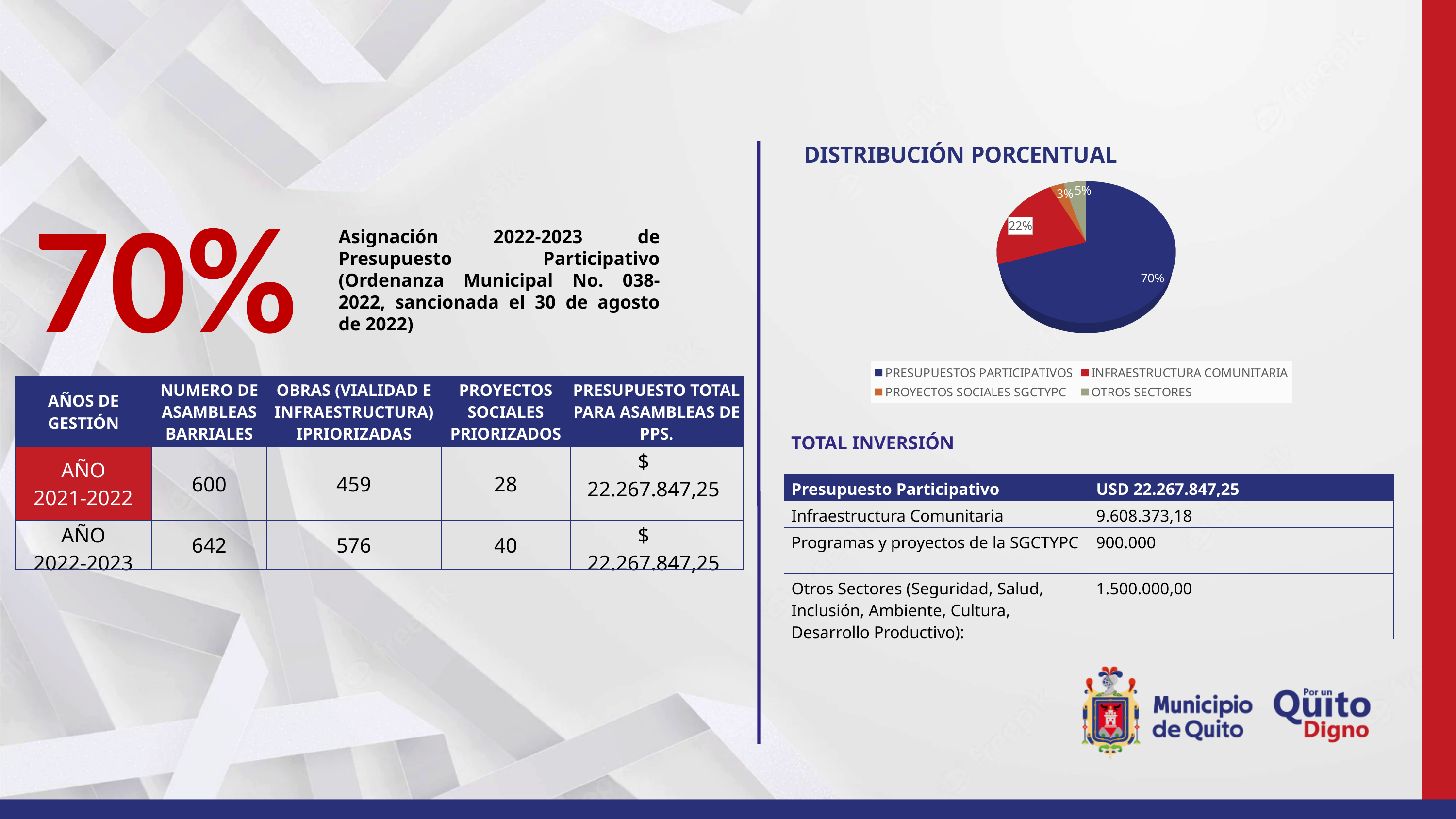
What percentage does the pie chart show for PRESUPUESTOS PARTICIPATIVOS? 70% How many entries does the legend of the pie chart list? 4 Which category has the largest slice in the pie chart? PRESUPUESTOS PARTICIPATIVOS What kind of chart is shown under the title DISTRIBUCIÓN PORCENTUAL? Pie chart How many slices does the pie chart have? 4 Which category has the smallest slice in the pie chart? PROYECTOS SOCIALES SGCTYPC What colour is the PRESUPUESTOS PARTICIPATIVOS slice in the pie chart? Dark blue What percentage does the pie chart show for OTROS SECTORES? 5% In the pie chart, which is larger: OTROS SECTORES or PROYECTOS SOCIALES SGCTYPC? OTROS SECTORES In the pie chart, what is the difference in percentage points between PRESUPUESTOS PARTICIPATIVOS and INFRAESTRUCTURA COMUNITARIA? 48 What percentage does the pie chart show for INFRAESTRUCTURA COMUNITARIA? 22% What percentage does the pie chart show for PROYECTOS SOCIALES SGCTYPC? 3%